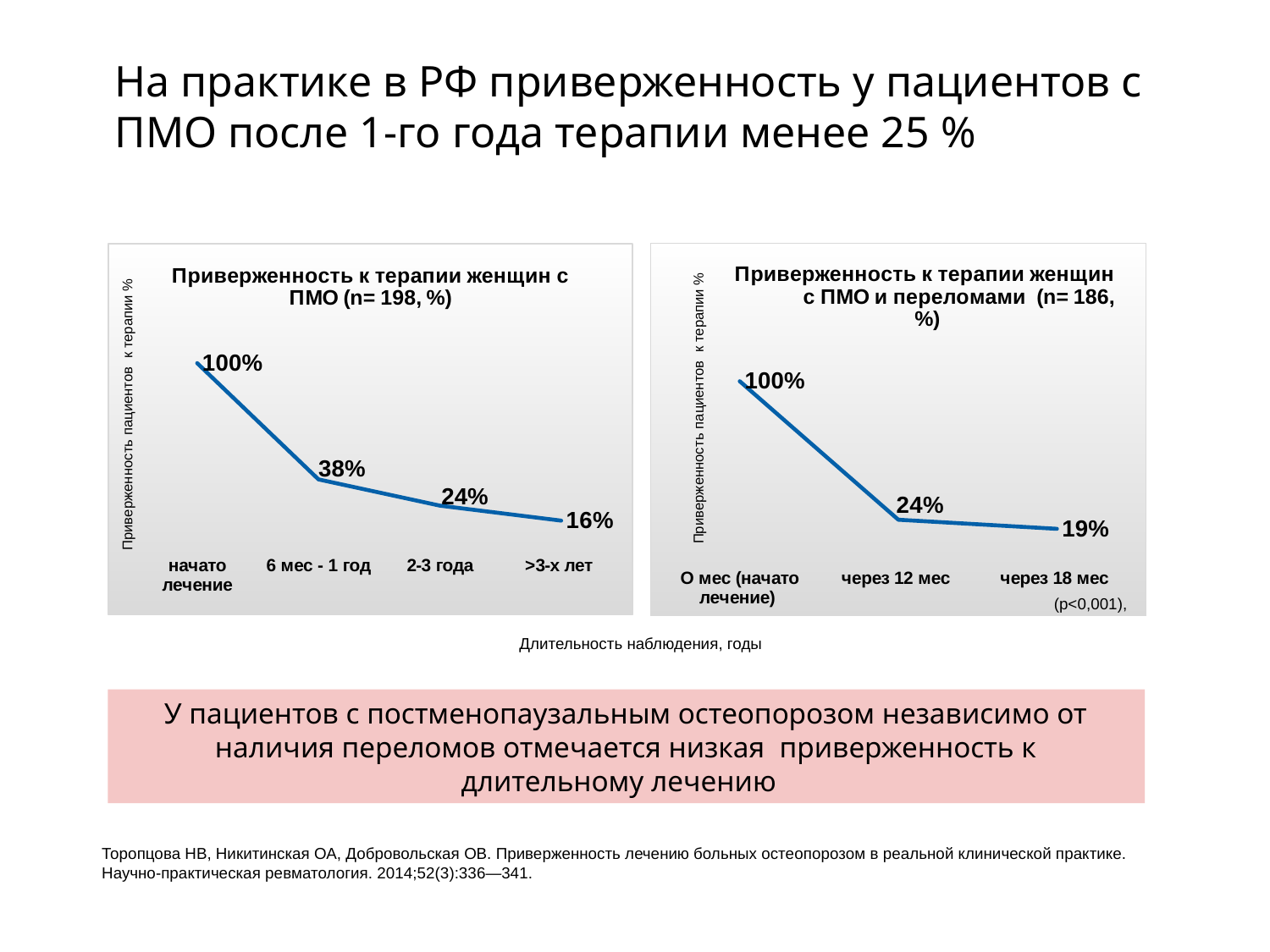
In the left chart (Приверженность к терапии женщин с ПМО), what is the value for '>3-х лет'? 16% In the left chart (Приверженность к терапии женщин с ПМО), which category has the lowest value? >3-х лет In the left chart (Приверженность к терапии женщин с ПМО), what is the value for '6 мес - 1 год'? 38% In the left chart (Приверженность к терапии женщин с ПМО), what is the difference between the values for '6 мес - 1 год' and '2-3 года'? 14% In the right chart (Приверженность к терапии женщин с ПМО и переломами), which category has the highest value? О мес (начато лечение) Which is larger: the value for '2-3 года' in the left chart or the value for 'через 18 мес' in the right chart? 2-3 года in the left chart In the right chart (Приверженность к терапии женщин с ПМО и переломами), what is the value for 'через 18 мес'? 19% How many data points are plotted in the left chart (Приверженность к терапии женщин с ПМО)? 4 In the right chart (Приверженность к терапии женщин с ПМО и переломами), what is the difference between the values for 'через 12 мес' and 'через 18 мес'? 5% In the right chart (Приверженность к терапии женщин с ПМО и переломами), what is the value for 'через 12 мес'? 24% In the left chart (Приверженность к терапии женщин с ПМО), do the values rise or fall along the x axis? Fall What type of chart is the right chart (Приверженность к терапии женщин с ПМО и переломами)? Line chart